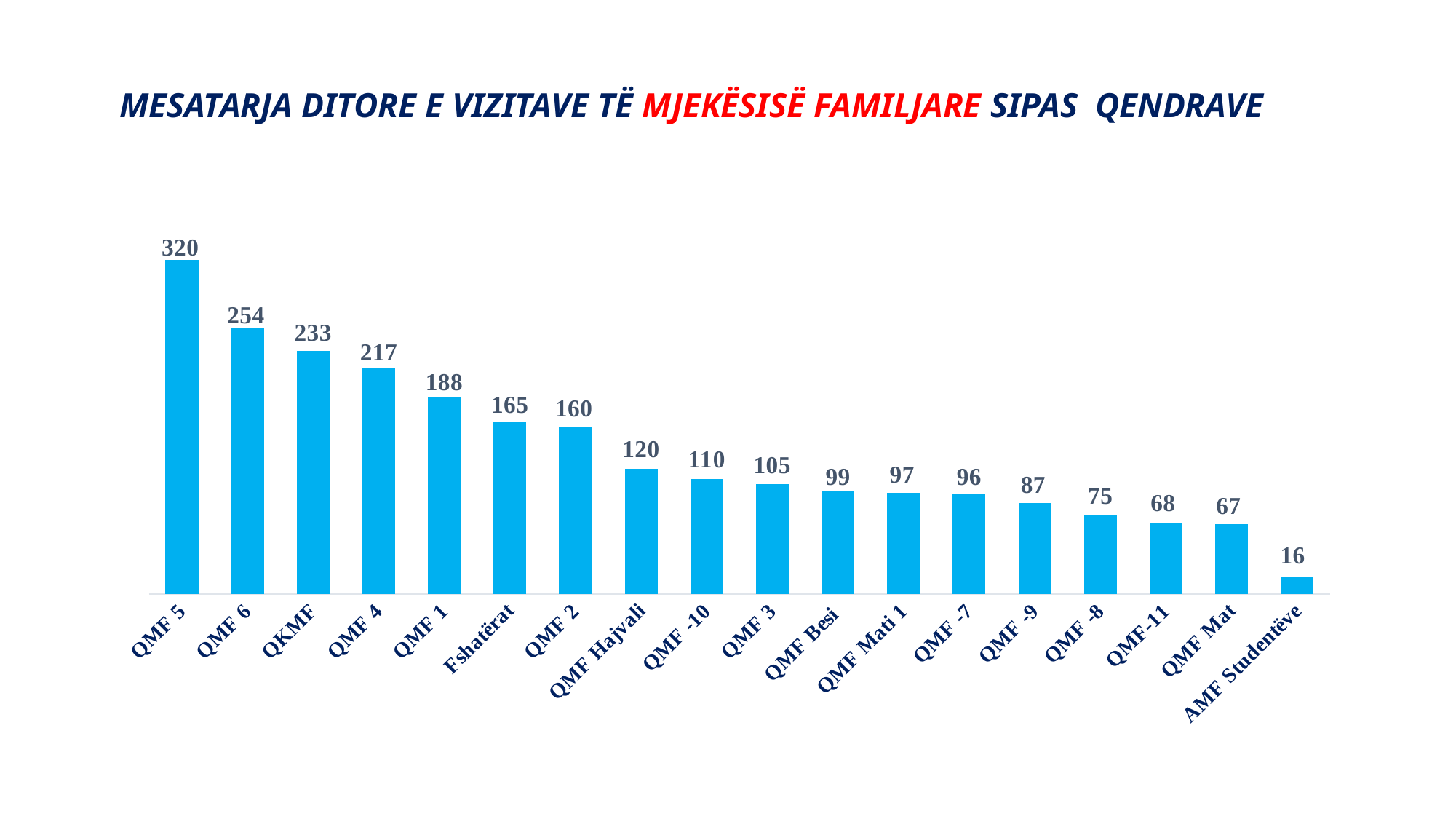
What is the value for QMF Hajvali? 120 Which category has the lowest value? AMF Studentëve What is the value for QMF Mat? 67 What is the value for QMF 5? 320 Which category has the highest value? QMF 5 Which is larger, the value for QMF -8 or the value for QMF -9? QMF -9 How many categories are shown on the chart? 18 What is the difference between the values for QMF 6 and QKMF? 21 What is the difference between the values for QMF 5 and AMF Studentëve? 304 Which is larger, the value for Fshatërat or the value for QMF 2? Fshatërat What kind of chart is shown on the slide? bar chart Do the values rise or fall from left to right along the x axis? fall